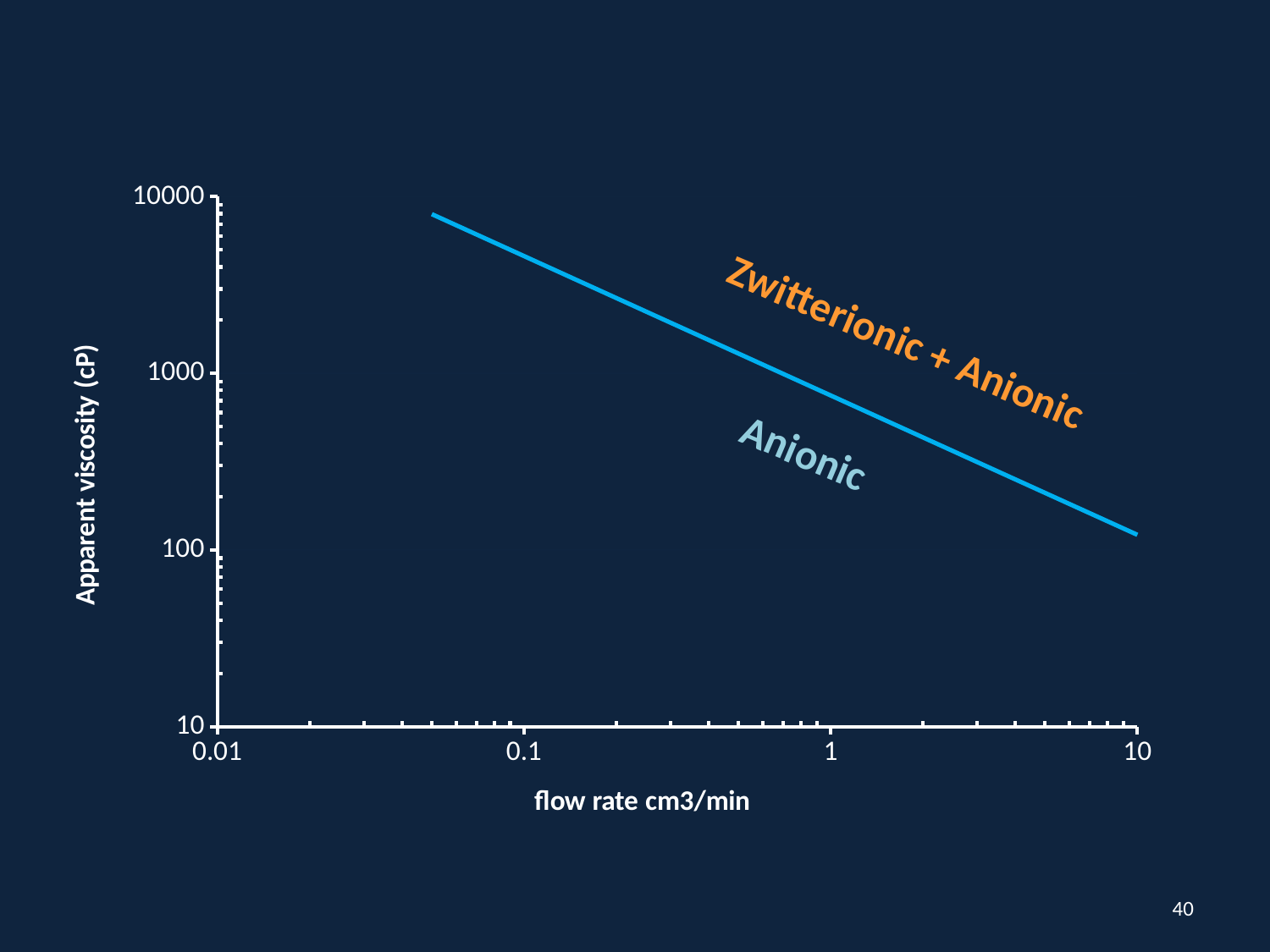
Is the apparent viscosity at a flow rate of 10 cm3/min greater or less than 1000 cP? less How many lines are plotted on the chart? 1 Is the apparent viscosity at a flow rate of 0.1 cm3/min greater or less than 10000 cP? less Is the apparent viscosity at a flow rate of 0.1 cm3/min greater or less than 1000 cP? greater Does apparent viscosity rise or fall as flow rate increases along the x axis? fall What is the label of the y axis? Apparent viscosity (cP) What is the label of the x axis? flow rate cm3/min Which has the higher apparent viscosity: the point at flow rate 0.1 cm3/min or the point at flow rate 10 cm3/min? 0.1 cm3/min What kind of chart is shown on the slide? line chart